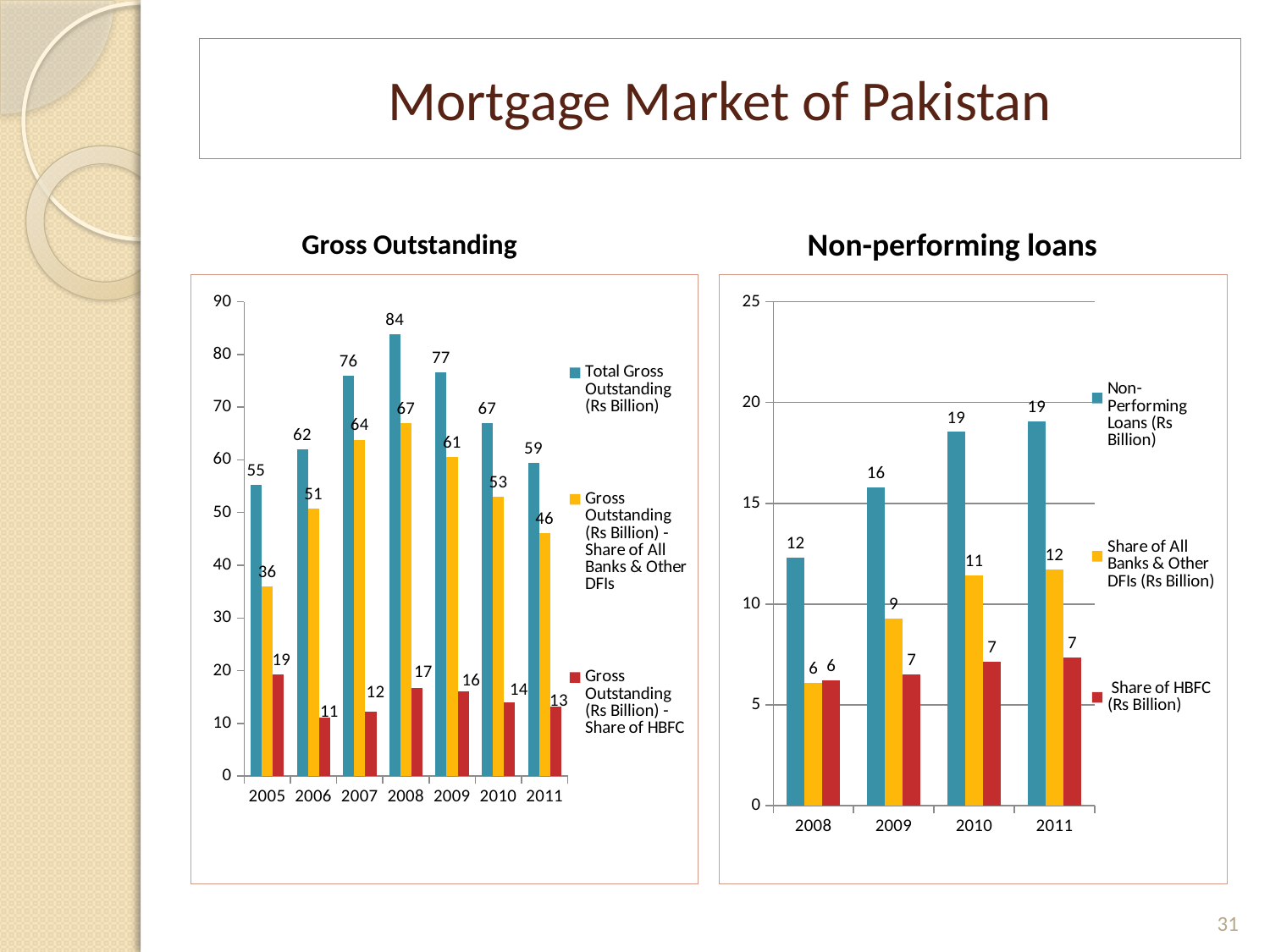
In the Non-performing loans chart, which is larger in 2010: Share of All Banks & Other DFIs or Share of HBFC? Share of All Banks & Other DFIs In the Gross Outstanding chart, what is the difference between the Total Gross Outstanding values for 2008 and 2011? 25 In the Gross Outstanding chart, which year has the highest Total Gross Outstanding (Rs Billion)? 2008 What kind of chart is the Non-performing loans chart? bar chart In the Gross Outstanding chart, how many series does the legend list? 3 In the Non-performing loans chart, does the Non-Performing Loans value rise or fall from 2008 to 2011? rise In the Non-performing loans chart, what is the Share of All Banks & Other DFIs (Rs Billion) value for 2011? 12 In the Gross Outstanding chart, which year has the lowest Gross Outstanding - Share of HBFC value? 2006 In the Non-performing loans chart, what colour represents the Share of HBFC (Rs Billion) series? red In the Non-performing loans chart, what is the Non-Performing Loans (Rs Billion) value for 2009? 16 In the Gross Outstanding chart, how many years are shown on the x axis? 7 In the Gross Outstanding chart, what is the Total Gross Outstanding (Rs Billion) value for 2008? 84